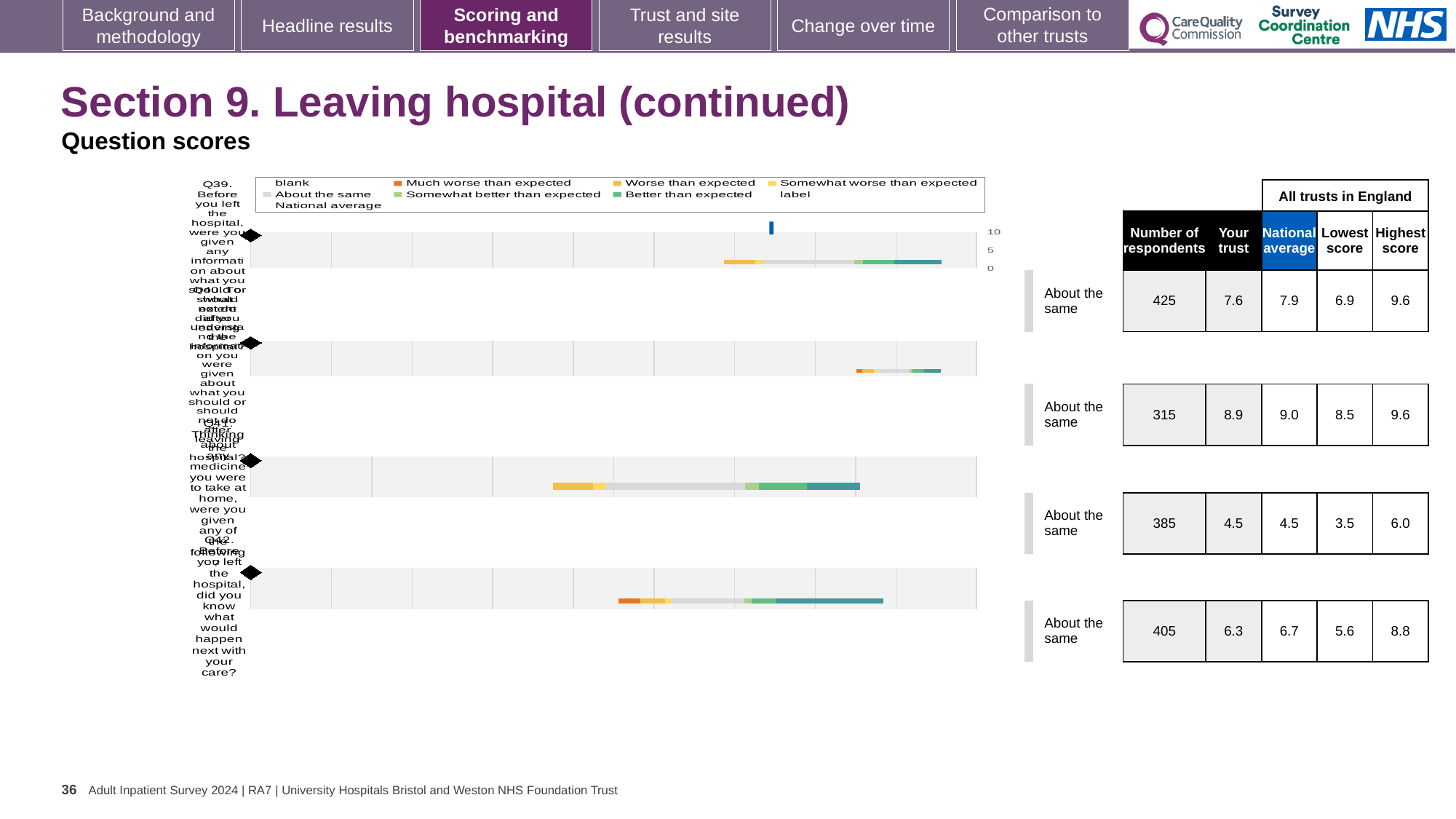
For the row with 425 respondents, which is larger: the 'Your trust' score or the National average? National average Which row in the table has the highest 'Your trust' score? the row with 315 respondents (8.9) For the row with 405 respondents, what is the difference between the National average and the 'Your trust' score? 0.4 What kind of chart is shown on the slide? bar chart What benchmark label is shown next to each of the four question rows? About the same How many question rows (bars) does the chart show? 4 In the table beside the chart, what is the Highest score for the row with 385 respondents? 6.0 In the table beside the chart, what is the Lowest score for the row with 405 respondents? 5.6 In the table beside the chart, what is the National average for the row with 315 respondents? 9.0 Which row in the table has the lowest 'Your trust' score? the row with 385 respondents (4.5) In the table beside the chart, what is the 'Your trust' score for the row with 425 respondents? 7.6 What colour represents 'Much worse than expected' in the chart legend? orange